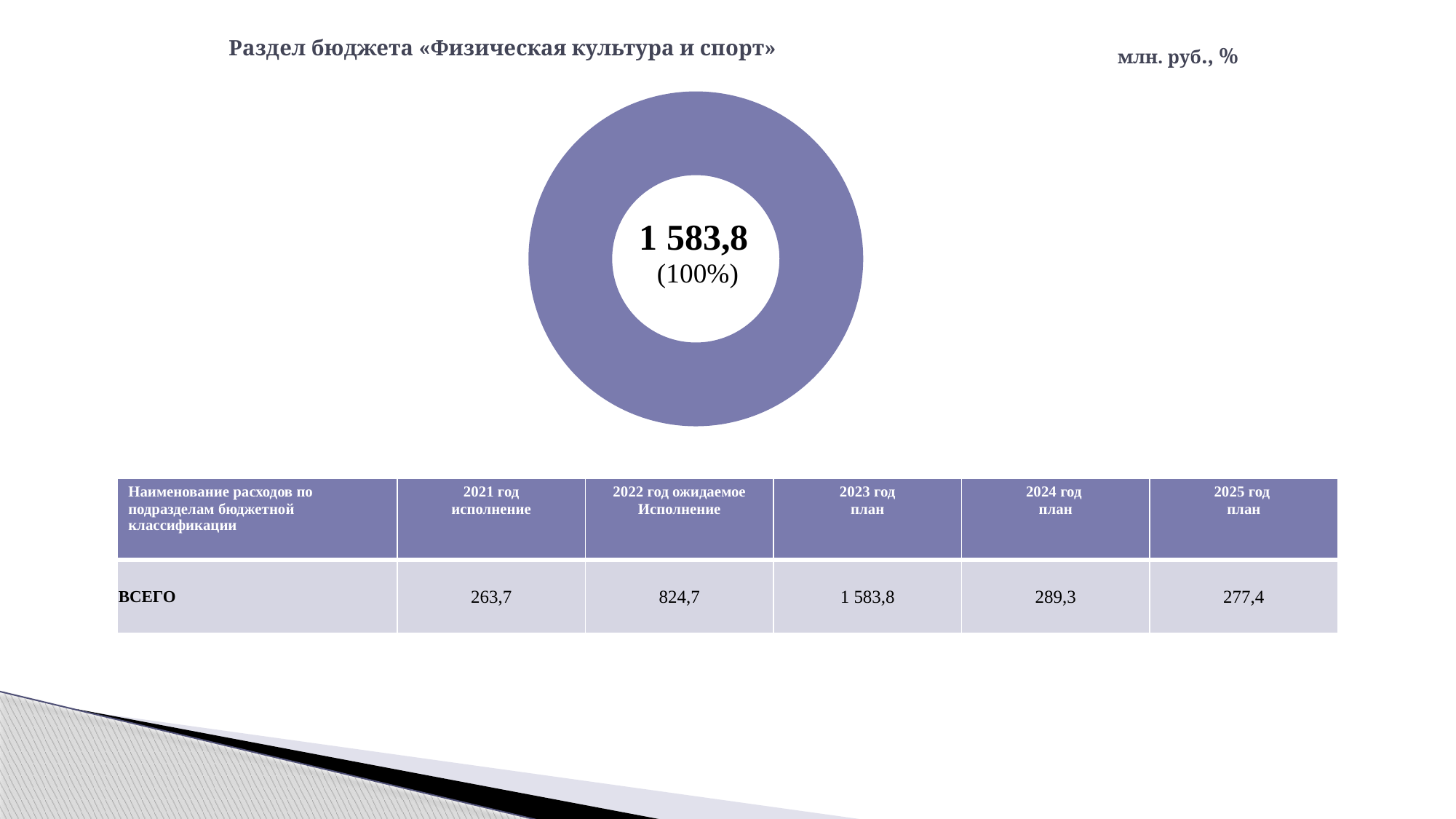
How many segments does the donut chart contain? 1 What percentage share is printed in the centre of the donut chart? 100% What total value is printed in the centre of the donut chart? 1 583,8 What kind of chart is shown on the slide? Donut (pie) chart What units are indicated for the chart values in the top right of the slide? млн. руб., % What is the title of the slide above the donut chart? Раздел бюджета «Физическая культура и спорт»